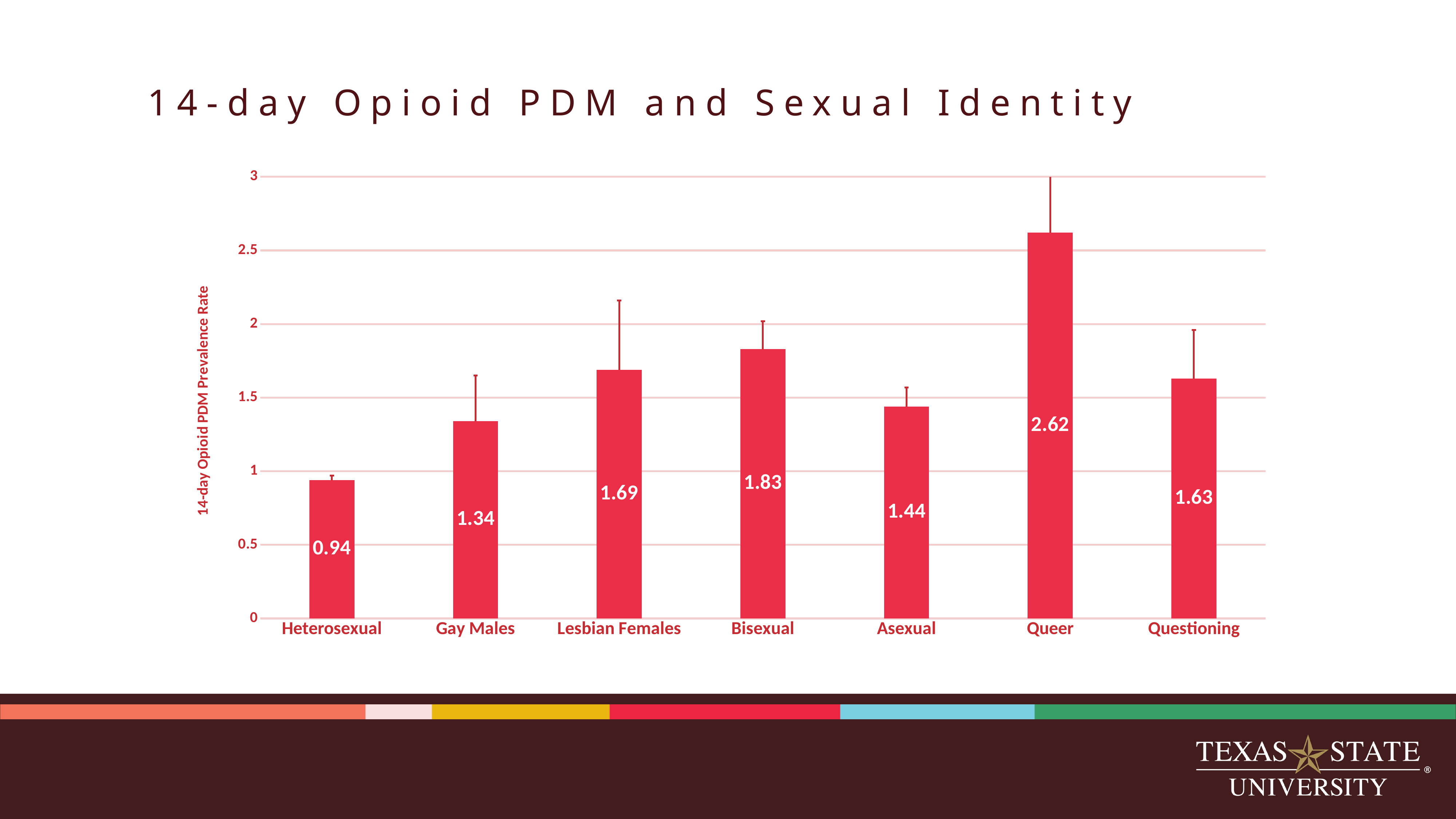
What is the 14-day Opioid PDM prevalence rate for Asexual? 1.44 What is the difference between the prevalence rates for Queer and Heterosexual? 1.68 What is the 14-day Opioid PDM prevalence rate for Heterosexual? 0.94 What is the 14-day Opioid PDM prevalence rate for Queer? 2.62 What is the 14-day Opioid PDM prevalence rate for Questioning? 1.63 What is the difference between the prevalence rates for Bisexual and Gay Males? 0.49 Which has a higher 14-day Opioid PDM prevalence rate, Lesbian Females or Questioning? Lesbian Females Which sexual identity category has the highest 14-day Opioid PDM prevalence rate? Queer Which sexual identity category has the lowest 14-day Opioid PDM prevalence rate? Heterosexual What kind of chart is shown on the slide? Bar chart Is the value for Gay Males greater or less than 1.5? less How many sexual identity categories are shown on the chart? 7